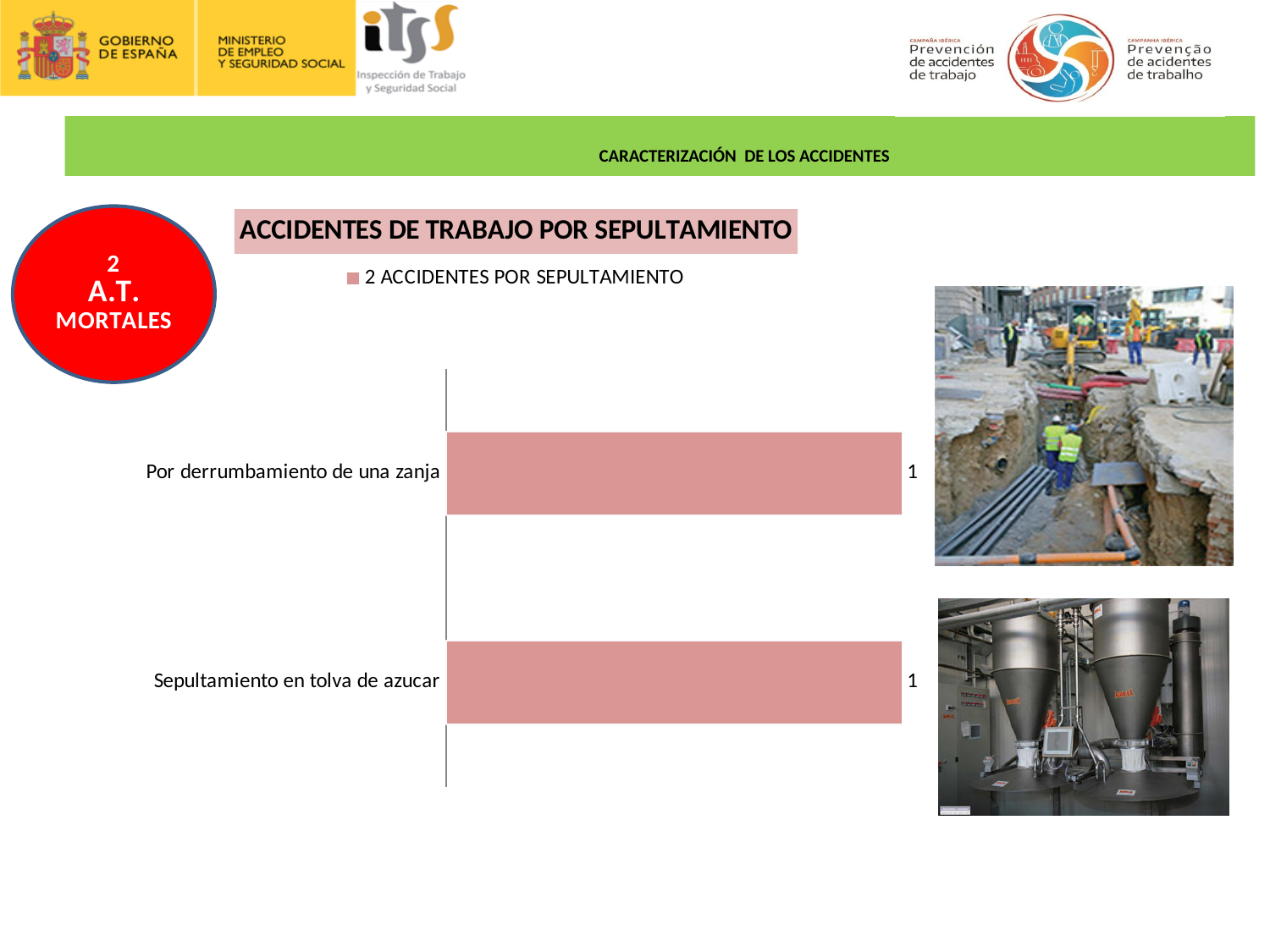
What kind of chart is shown on the slide? Bar chart How many series does the chart legend list? 1 What is the legend entry of the chart? 2 ACCIDENTES POR SEPULTAMIENTO How many categories are shown in the bar chart? 2 What is the title shown above the chart? ACCIDENTES DE TRABAJO POR SEPULTAMIENTO What is the value for "Por derrumbamiento de una zanja"? 1 What is the difference between the values for "Por derrumbamiento de una zanja" and "Sepultamiento en tolva de azucar"? 0 What is the value for "Sepultamiento en tolva de azucar"? 1